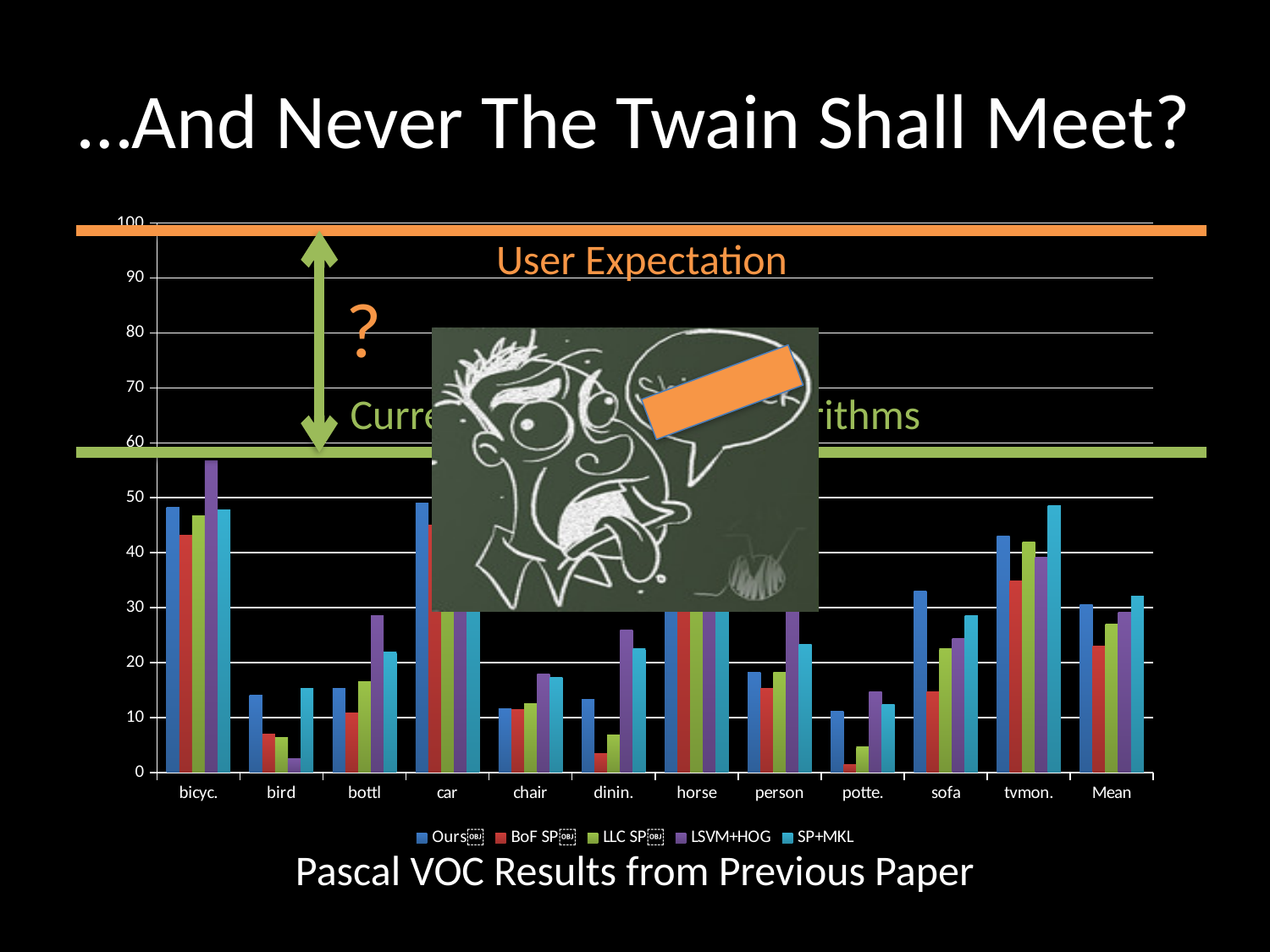
Which series has the lowest value in the bird category? LSVM+HOG What is the caption below the chart? Pascal VOC Results from Previous Paper In the bird category, which is larger: the value for Ours or the value for BoF SP? Ours Is the value for BoF SP in the Mean category greater or less than 20? greater Which series has the highest value in the bicyc. category? LSVM+HOG What label is given to the orange horizontal line at the top of the chart? User Expectation Is the value for LSVM+HOG in the bicyc. category greater or less than 50? greater What kind of chart is shown on the slide? bar chart How many categories are shown along the x axis of the chart? 12 Is the value for Ours in the bird category greater or less than 10? greater How many series does the chart's legend list? 5